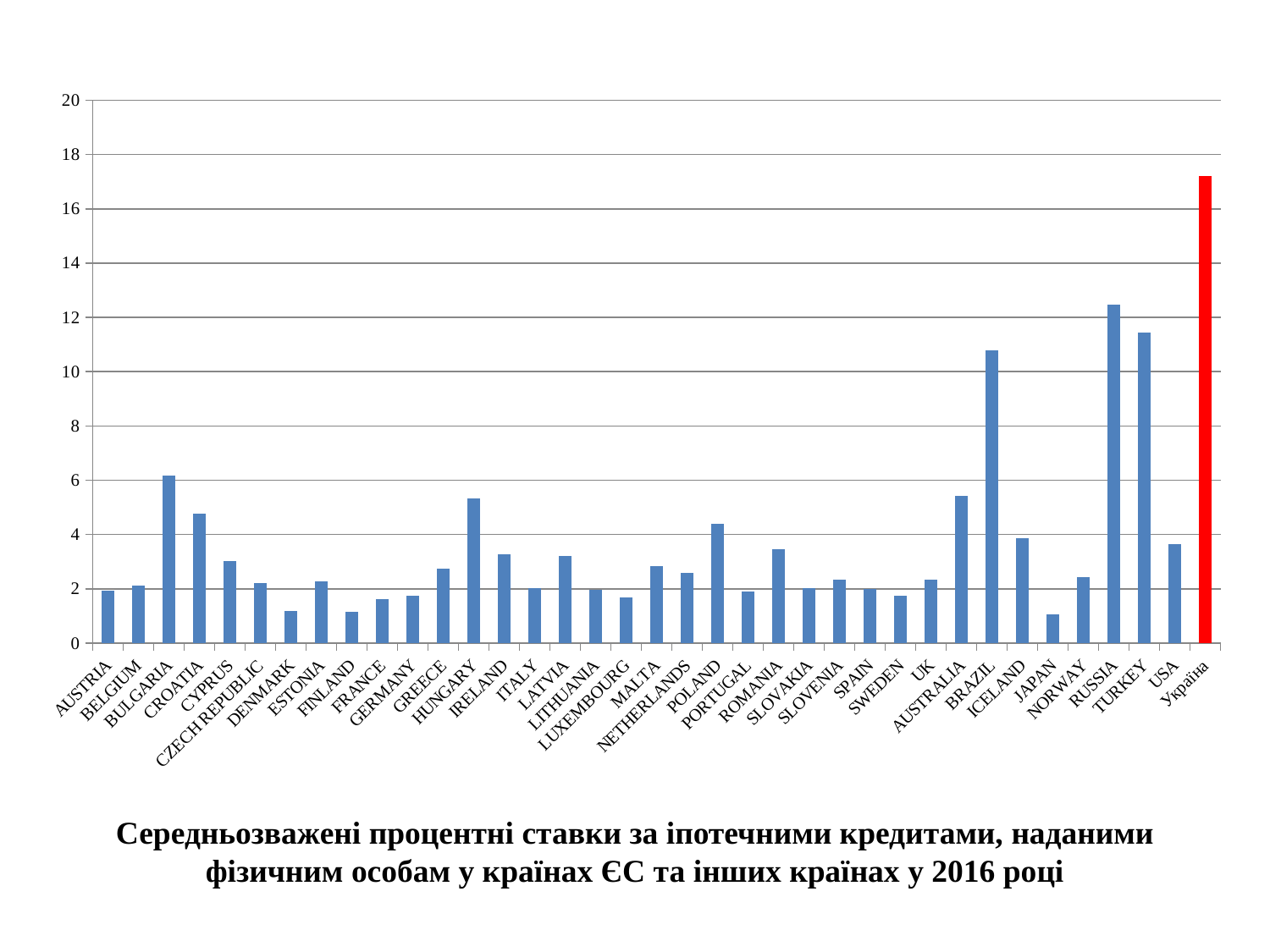
Which has the larger value, RUSSIA or TURKEY? RUSSIA Is the value for JAPAN greater or less than 2? less Is the value for USA greater or less than 4? less Which has the larger value, BULGARIA or CROATIA? BULGARIA What colour is the bar for Україна? red How many countries are shown on the x axis of the chart? 37 Is the value for CROATIA greater or less than 4? greater What kind of chart is shown on the slide? bar chart Which country has the highest bar in the chart? Україна